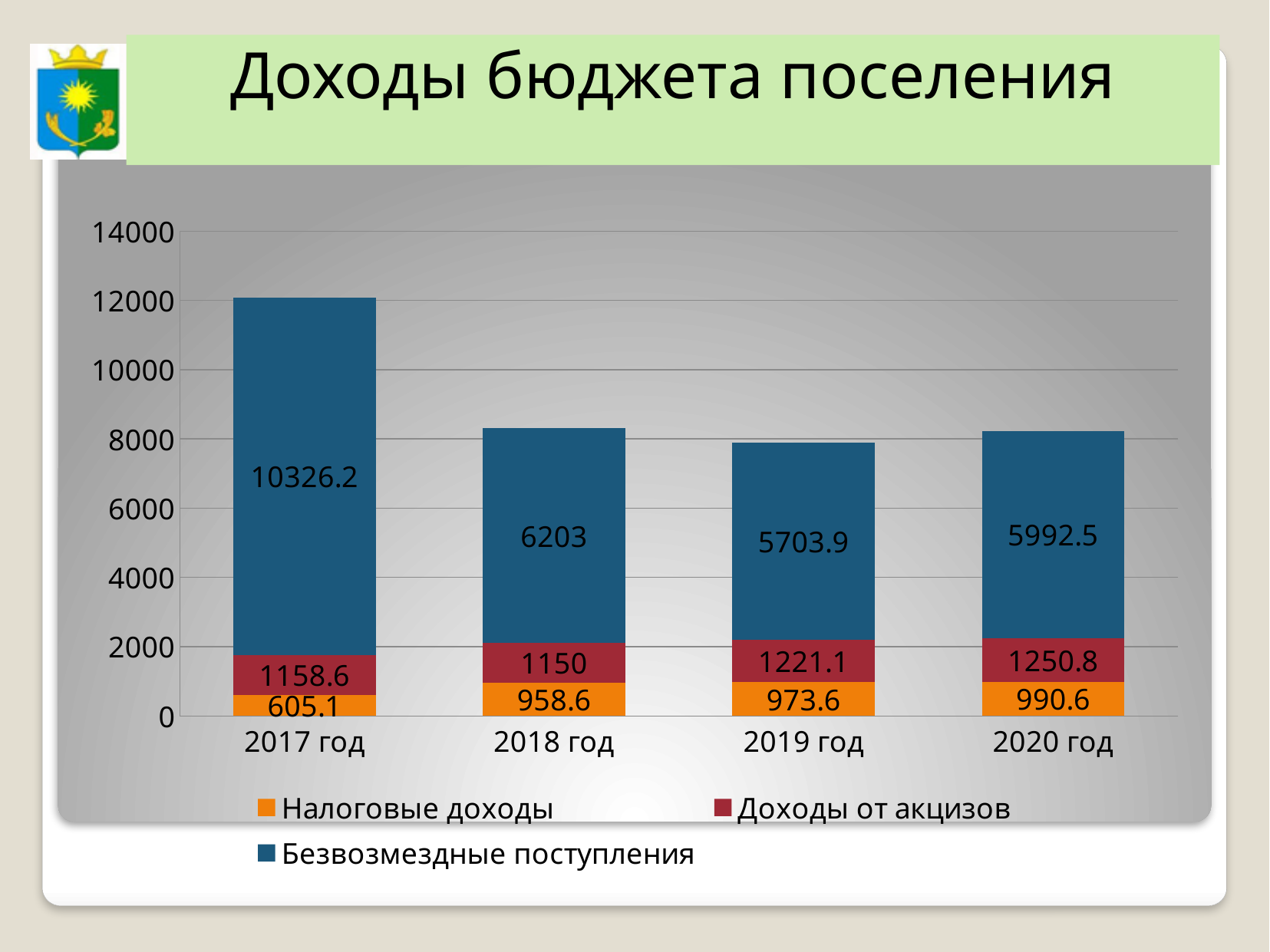
What type of chart is shown on the slide? Stacked bar chart What is the difference between Безвозмездные поступления in 2017 год and 2018 год? 4123.2 How many series does the legend list? 3 What is the total of the stacked bar for 2018 год? 8311.6 What is the value of Безвозмездные поступления for 2017 год? 10326.2 What is the title of the slide? Доходы бюджета поселения What is the value of Налоговые доходы for 2019 год? 973.6 How many years are shown on the x axis? 4 What is the value of Доходы от акцизов for 2020 год? 1250.8 In which year is Безвозмездные поступления the highest? 2017 год In which year is Налоговые доходы the lowest? 2017 год Which is larger: Доходы от акцизов in 2019 год or in 2018 год? 2019 год